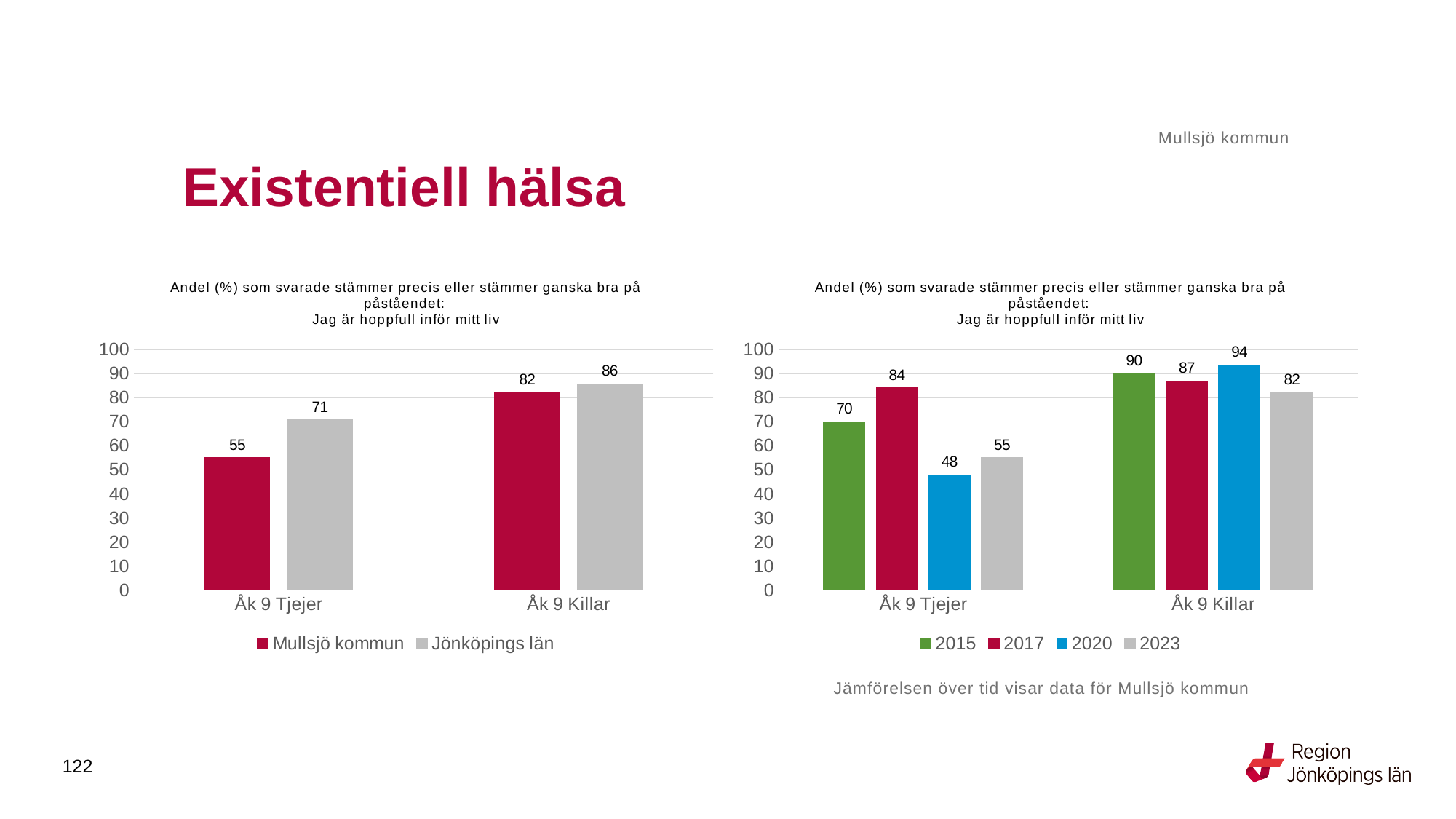
How many series does the legend of the right chart list? 4 In the right chart, what is the value for 2015 for Åk 9 Killar? 90 In the left chart, what is the value for Jönköpings län for Åk 9 Killar? 86 In the right chart, which year has the highest value for Åk 9 Killar? 2020 What kind of chart is the right chart? Bar chart In the left chart, which is larger for Åk 9 Killar: Mullsjö kommun or Jönköpings län? Jönköpings län In the left chart, what is the value for Mullsjö kommun for Åk 9 Tjejer? 55 In the right chart, which year has the lowest value for Åk 9 Tjejer? 2020 In the left chart, what is the difference between Jönköpings län and Mullsjö kommun for Åk 9 Tjejer? 16 In the right chart, what is the difference between the 2017 and 2023 values for Åk 9 Tjejer? 29 In the right chart, what is the value for 2020 for Åk 9 Tjejer? 48 How many series does the legend of the left chart list? 2